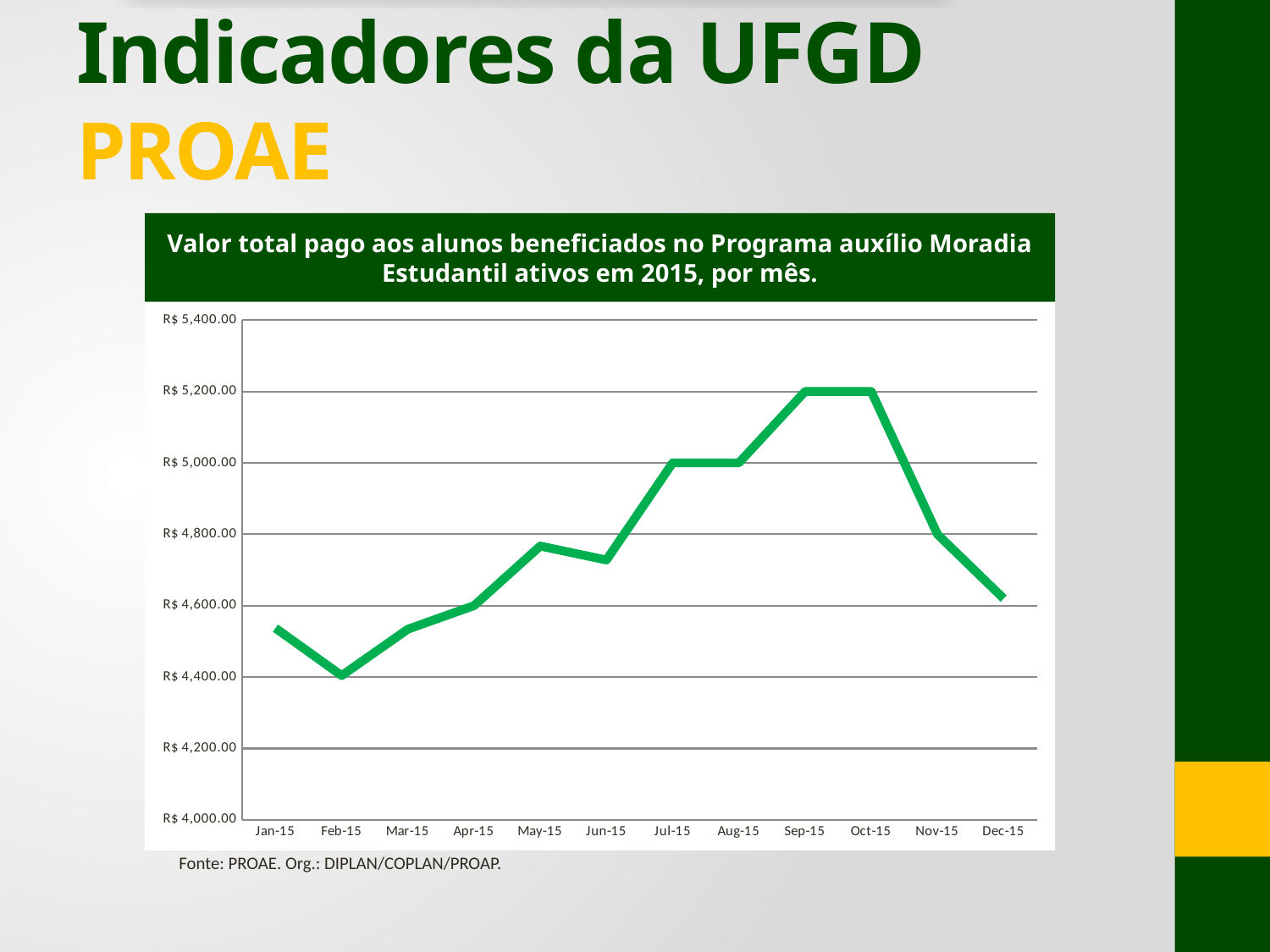
Is the value for May-15 greater or less than R$ 4,600.00? greater Do the values rise or fall from Feb-15 to Sep-15? rise What kind of chart is shown on the slide? line chart What is the value for Sep-15? R$ 5,200.00 What is the value for Nov-15? R$ 4,800.00 Which month has the lowest value in the chart? Feb-15 Is the value for Jan-15 greater or less than R$ 4,600.00? less Which is larger, the value for May-15 or the value for Jun-15? May-15 Is the value for Dec-15 greater or less than R$ 4,800.00? less How many months are plotted on the x axis of the chart? 12 What is the value for Jul-15? R$ 5,000.00 What is the title of the chart? Valor total pago aos alunos beneficiados no Programa auxílio Moradia Estudantil ativos em 2015, por mês.